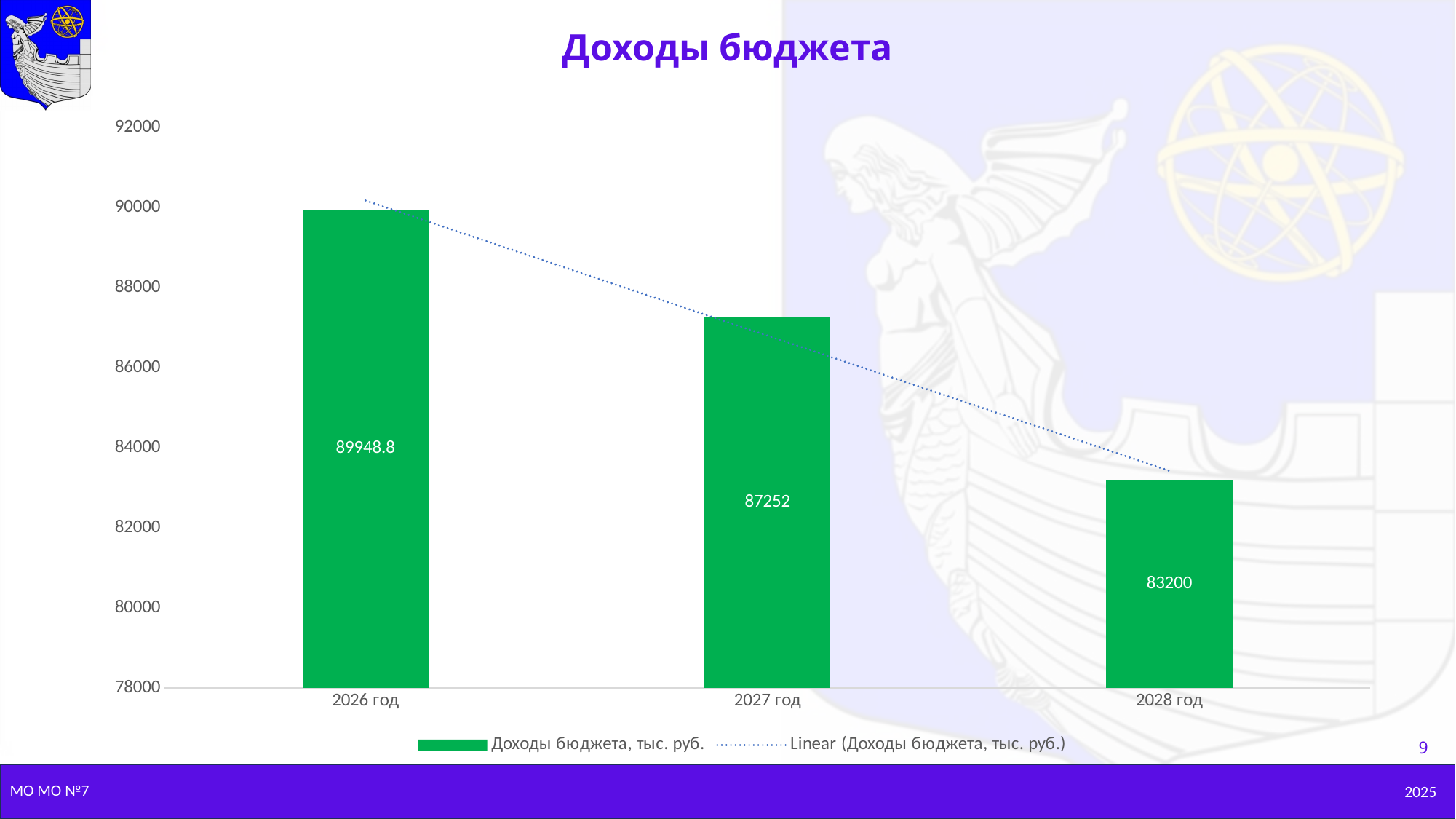
Which is larger, the value for 2027 год or the value for 2028 год? 2027 год Which year has the lowest budget revenue? 2028 год What kind of chart is this? bar chart What is the difference between the values for 2027 год and 2028 год? 4052 What is the value for 2027 год? 87252 Do the values rise or fall from 2026 год to 2028 год? fall Which year has the highest budget revenue? 2026 год How many years are shown on the chart? 3 Is the value for 2028 год greater or less than 84000? less What is the value for 2026 год? 89948.8 What is the difference between the values for 2026 год and 2027 год? 2696.8 What is the value for 2028 год? 83200